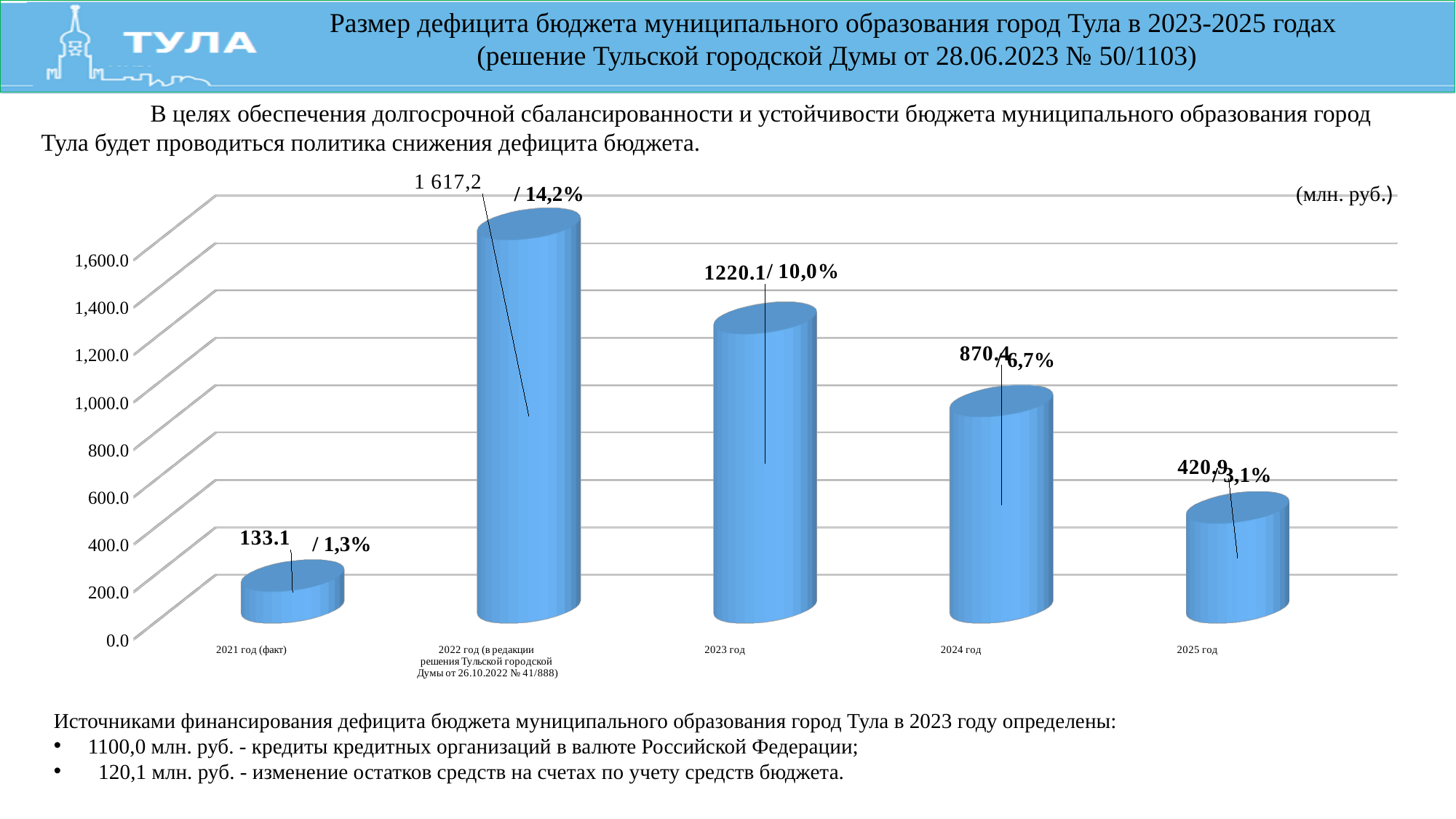
What kind of chart is shown on the slide? bar chart What unit is indicated in the top right corner of the chart? млн. руб. Which is larger, the value for 2024 год or the value for 2025 год? 2024 год What percentage is shown next to the 2024 год bar? 6,7% Which year has the highest deficit value? 2022 год (в редакции решения Тульской городской Думы от 26.10.2022 № 41/888) What is the budget deficit value shown for 2023 год? 1220.1 What is the difference between the values for 2023 год and 2024 год? 349.7 Which year has the lowest deficit value? 2021 год (факт) Do the values rise or fall from 2023 год to 2025 год? fall How many years (categories) are plotted on the chart? 5 What is the value labelled for 2021 год (факт)? 133.1 What value is shown for 2025 год? 420,9